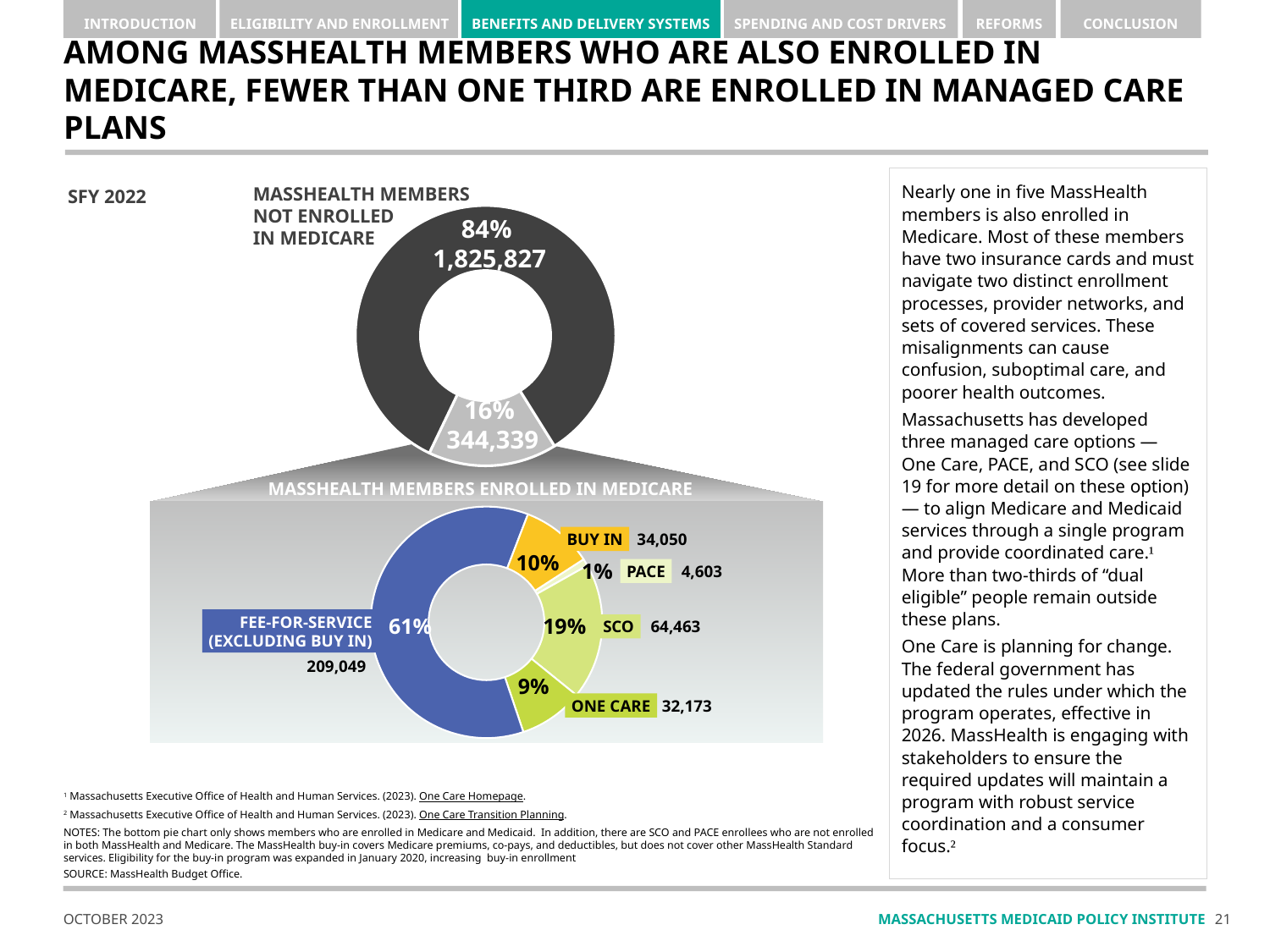
What kind of chart is used on this slide to show MassHealth members enrolled in Medicare? Pie (donut) chart In the bottom chart (MassHealth members enrolled in Medicare), which category has the smallest number of members? PACE In the bottom chart (MassHealth members enrolled in Medicare), which has more members, Buy In or One Care? Buy In In the top chart, how many MassHealth members are not enrolled in Medicare? 1,825,827 In the bottom chart (MassHealth members enrolled in Medicare), what is the difference in members between SCO and One Care? 32,290 In the bottom chart (MassHealth members enrolled in Medicare), how many categories are shown? 5 In the bottom chart (MassHealth members enrolled in Medicare), which category has the largest number of members? Fee-for-service (excluding buy in) In the bottom chart (MassHealth members enrolled in Medicare), how many members are in SCO? 64,463 In the top chart, what share of MassHealth members are not enrolled in Medicare? 84% What fiscal year is shown on the slide for the charts? SFY 2022 In the top chart, how many MassHealth members are enrolled in Medicare? 344,339 In the bottom chart (MassHealth members enrolled in Medicare), what share of members are in fee-for-service (excluding buy in)? 61%